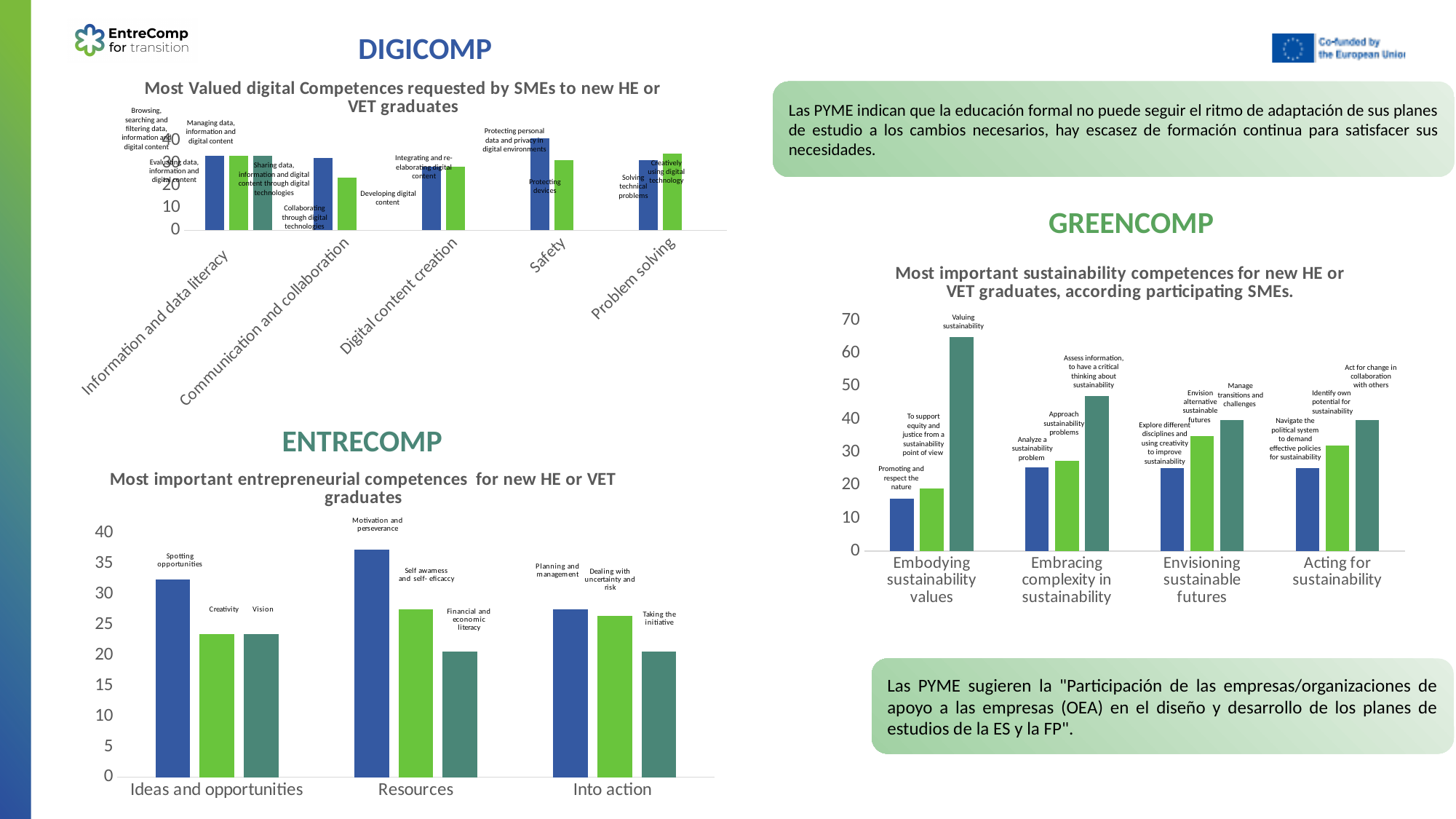
How many categories are shown on the x axis of the GREENCOMP chart? 4 In the ENTRECOMP chart, is the value for Spotting opportunities greater or less than 30? greater In the ENTRECOMP chart, which competence has the highest bar? Motivation and perseverance In the ENTRECOMP chart, is the value for Financial and economic literacy greater or less than 25? less In the GREENCOMP chart, which competence has the lowest bar? Promoting and respect the nature In the GREENCOMP chart, is the value for Assess information, to have a critical thinking about sustainability greater or less than 40? greater How many categories are shown on the x axis of the DIGICOMP chart? 5 How many categories are shown on the x axis of the ENTRECOMP chart? 3 What kind of chart is the DIGICOMP chart? bar chart In the ENTRECOMP chart, which is larger, Spotting opportunities or Creativity? Spotting opportunities In the GREENCOMP chart, which competence has the highest bar? Valuing sustainability